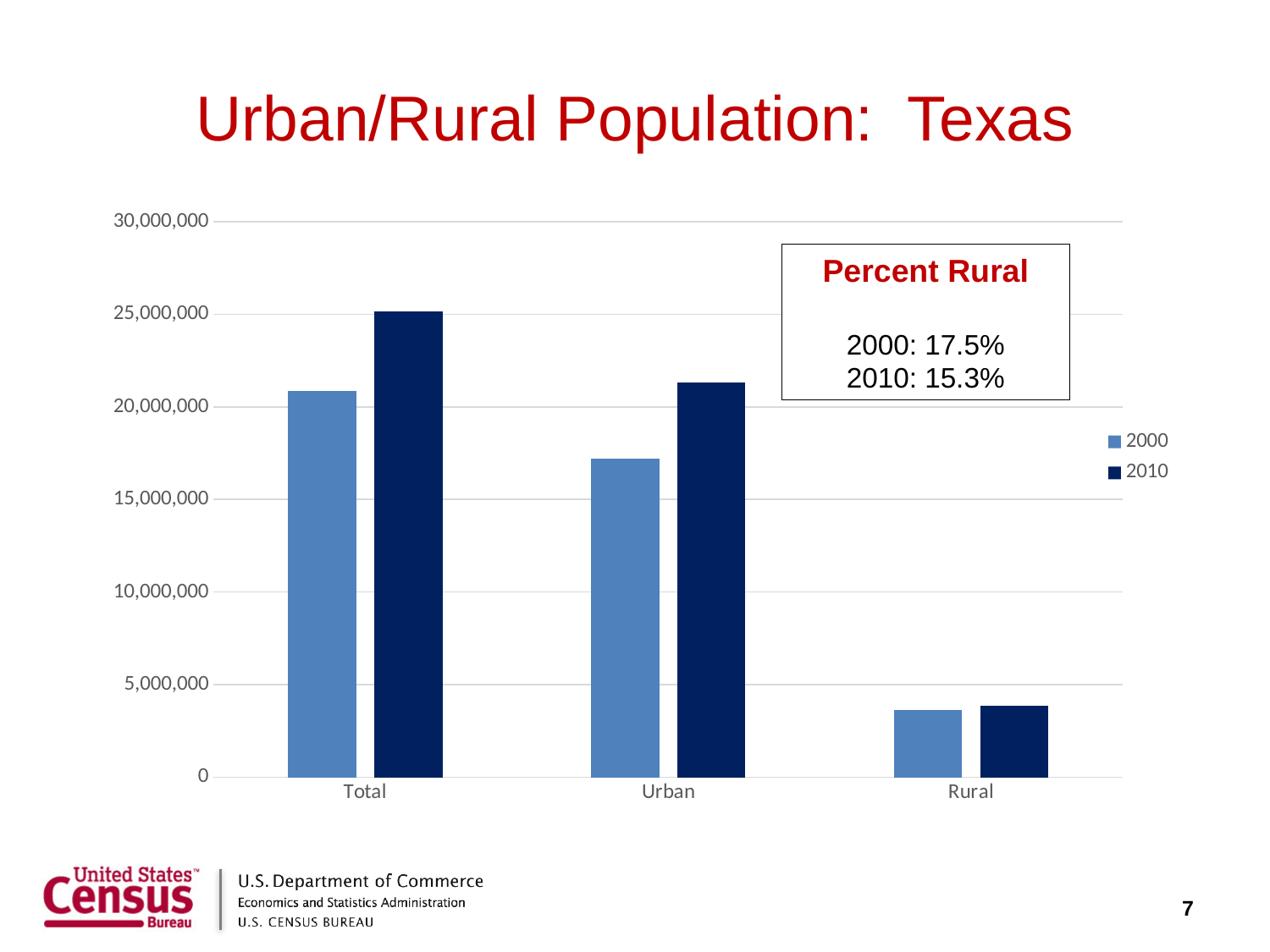
Is the value for Urban in 2010 greater or less than 20,000,000? greater How many categories are shown on the x axis? 3 Which category has the highest value for the 2010 series? Total Is the value for Urban in 2000 greater or less than 20,000,000? less Is the value for Rural in 2010 greater or less than 5,000,000? less What is the title of the chart? Urban/Rural Population: Texas For the Urban category, which series has the larger value, 2000 or 2010? 2010 What kind of chart is shown on the slide? bar chart How many series does the legend list? 2 According to the Percent Rural box on the chart, what was the percent rural in 2010? 15.3% Which category has the lowest value for the 2000 series? Rural